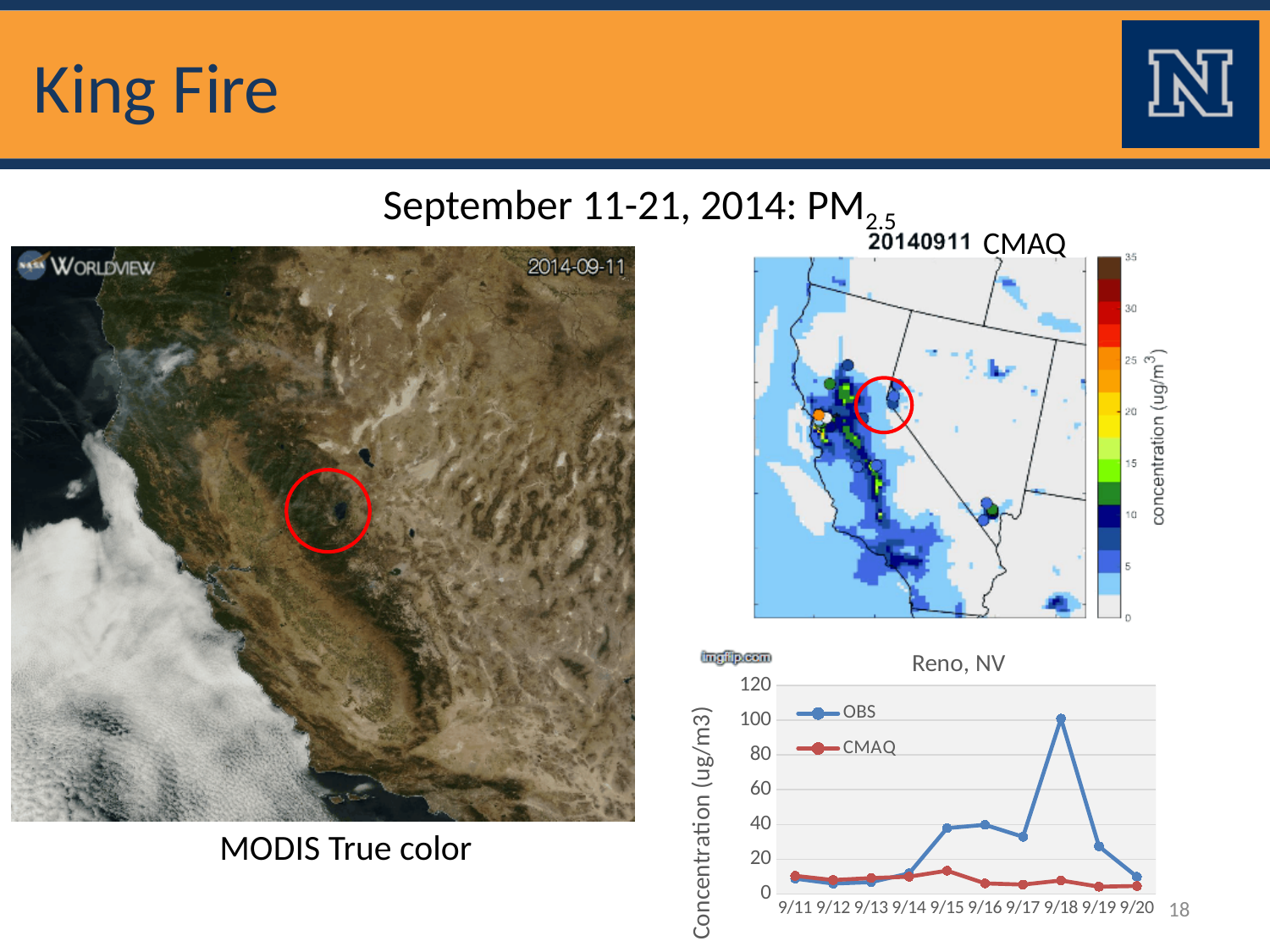
In the Reno, NV chart, which series has the larger value on 9/18, OBS or CMAQ? OBS In the Reno, NV chart, on which date does the OBS series reach its highest value? 9/18 How many dates are shown on the x axis of the Reno, NV chart? 10 How many series does the legend of the Reno, NV chart list? 2 In the Reno, NV chart, does the OBS series rise or fall from 9/18 to 9/20? fall In the Reno, NV chart, is the OBS value on 9/15 greater or less than 20? greater In the Reno, NV chart, on which date does the CMAQ series reach its highest value? 9/15 What is the y-axis label of the Reno, NV chart? Concentration (ug/m3) What kind of chart is the Reno, NV chart? line chart In the Reno, NV chart, is the OBS value on 9/18 greater or less than 80? greater What is the title of the line chart on the slide? Reno, NV In the Reno, NV chart, is the CMAQ value on 9/18 greater or less than 20? less